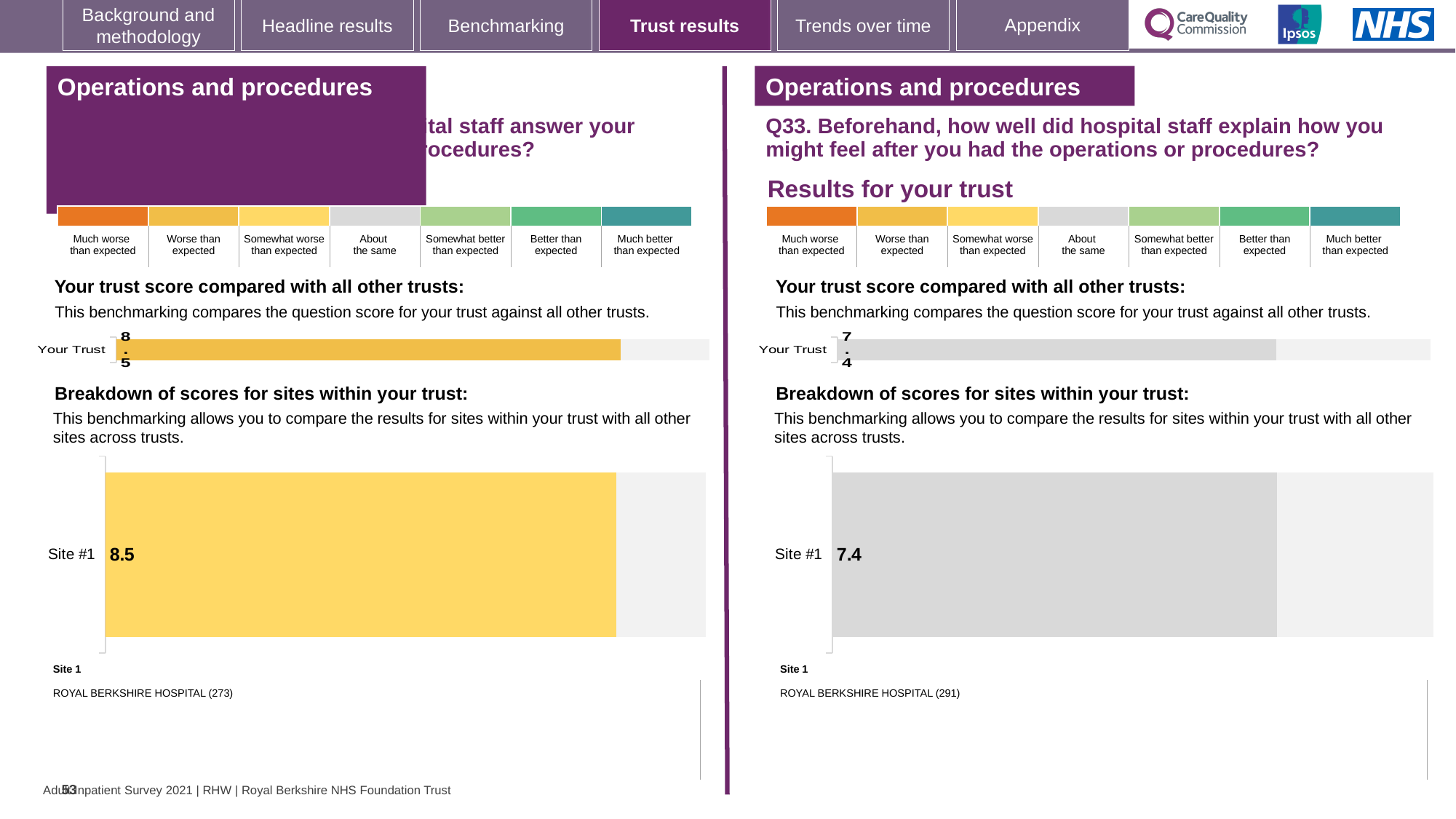
What colour is the Site #1 bar in the 'Breakdown of scores for sites within your trust' chart on the right half of the slide? Grey What is the difference between the Site #1 score on the left half of the slide and the Site #1 score on the right half (Q33)? 1.1 Which is larger: the Your Trust score on the left half of the slide or the Your Trust score on the right half (Q33)? The left half (8.5) What type of chart is used to show the Site #1 score on the right half of the slide? Bar chart On the right half of the slide, what is the score shown for Your Trust in the 'Your trust score compared with all other trusts' chart? 7.4 According to the colour key, which benchmark category does the yellow Site #1 bar on the left half of the slide correspond to? Somewhat worse than expected On the right half of the slide (Q33), what score is shown for Site #1 in the 'Breakdown of scores for sites within your trust' chart? 7.4 Which hospital is listed as Site 1 beneath the site breakdown chart on the right half of the slide? ROYAL BERKSHIRE HOSPITAL (291) On the left half of the slide, what is the score shown for Your Trust in the 'Your trust score compared with all other trusts' chart? 8.5 How many sites are shown in the 'Breakdown of scores for sites within your trust' chart on the right half of the slide? 1 How many sites are shown in the 'Breakdown of scores for sites within your trust' chart on the left half of the slide? 1 On the left half of the slide, what score is shown for Site #1 in the 'Breakdown of scores for sites within your trust' chart? 8.5